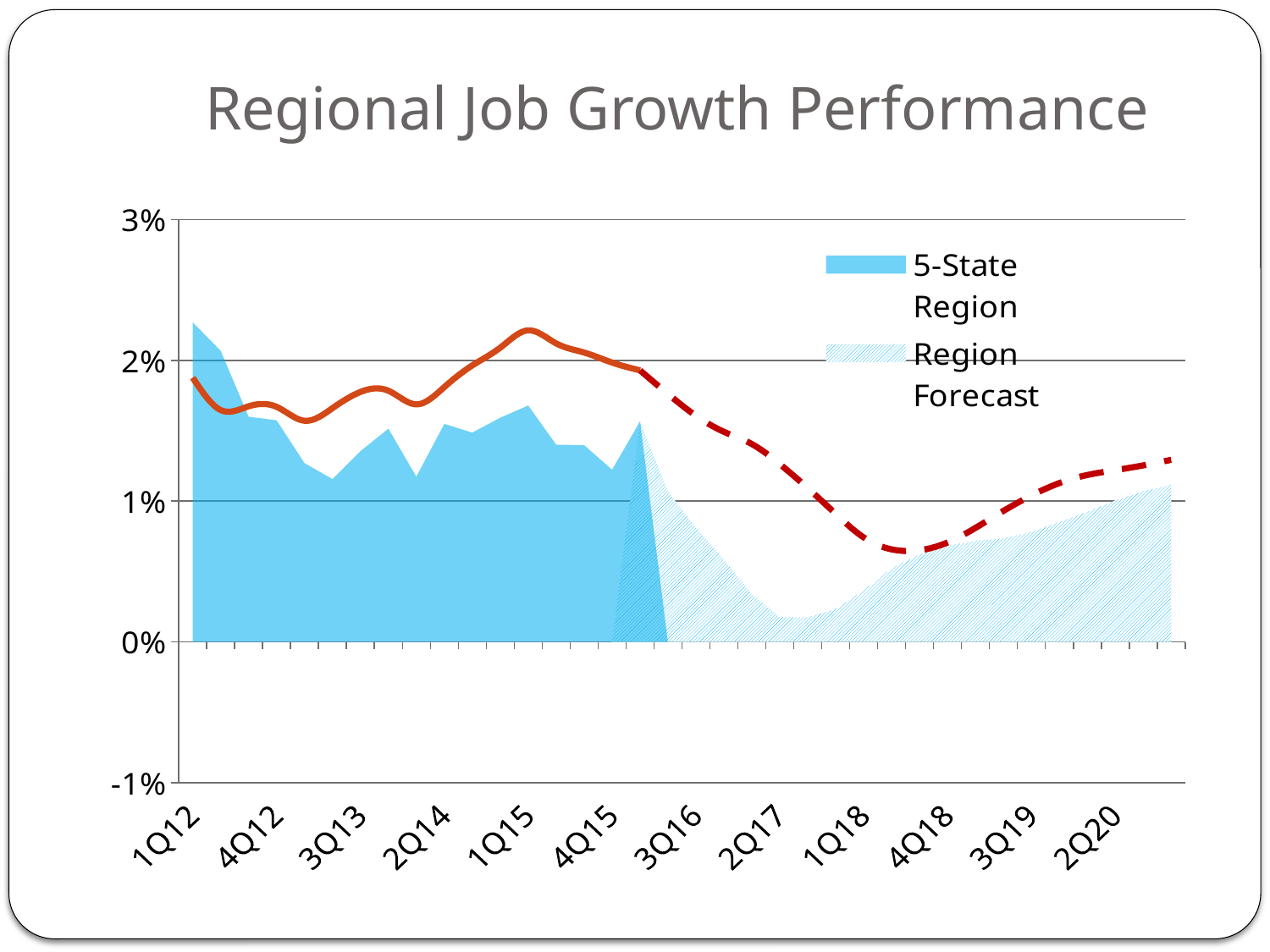
Is the 5-State Region value at 3Q13 greater or less than 2%? less How many series does the legend list? 2 Is the Region Forecast value at 2Q17 greater or less than 1%? less Is the Region Forecast value at 1Q18 greater or less than 1%? less Which is larger, the 5-State Region value at 1Q12 or at 4Q15? 1Q12 Does the Region Forecast area rise or fall from 2Q17 to 2Q20? rise What is the title of the chart? Regional Job Growth Performance At which x-axis label does the 5-State Region area reach its highest value? 1Q12 Does the 5-State Region area rise or fall from 1Q12 to 4Q12? fall What kind of chart is shown on the slide? Combination area and line chart How many quarter labels are shown on the x axis? 12